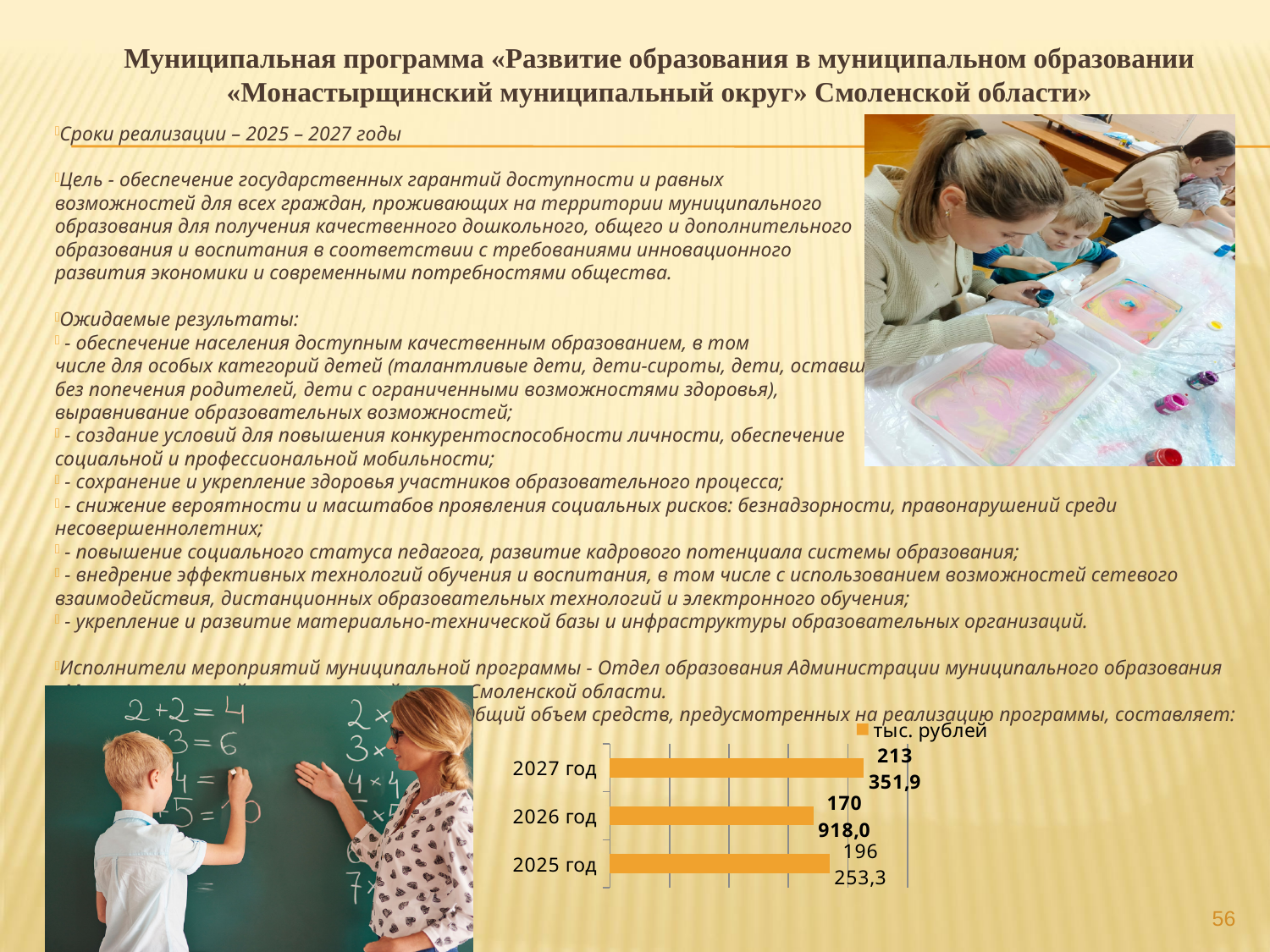
Which year has the lowest value in the chart? 2026 год Which is larger, the value for 2025 год or the value for 2026 год? 2025 год What is the difference between the values for 2025 год and 2026 год? 25 335,3 Which year has the highest value in the chart? 2027 год How many years (categories) are shown in the chart? 3 What unit is named in the chart legend? тыс. рублей What type of chart is shown at the bottom of the slide? bar chart What is the value for 2027 год in the chart? 213 351,9 What is the value for 2025 год in the chart? 196 253,3 What is the value for 2026 год in the chart? 170 918,0 How many series does the chart legend list? 1 What is the difference between the values for 2027 год and 2025 год? 17 098,6